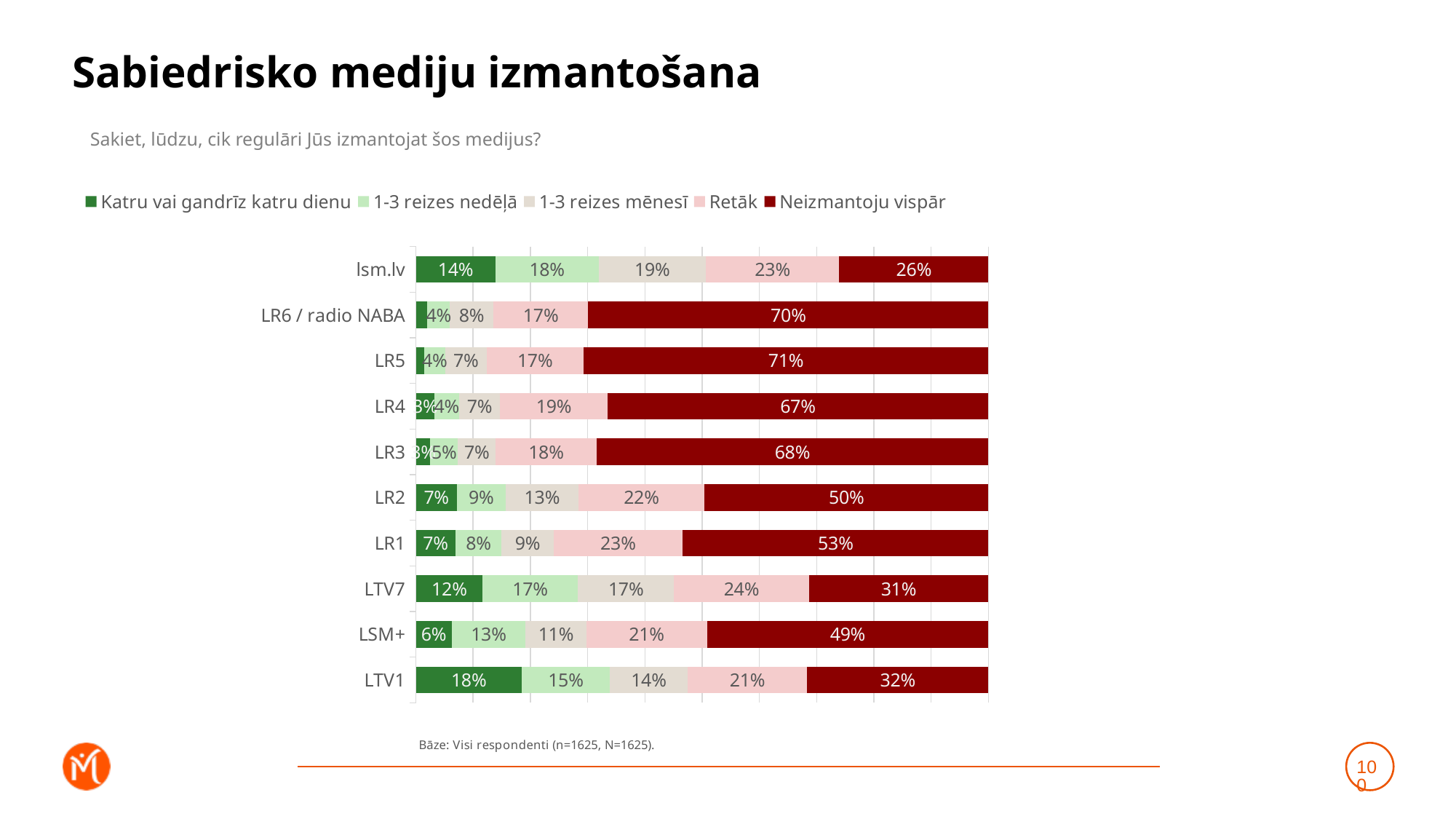
Which category has the highest 'Neizmantoju vispār' value? LR5 What kind of chart is shown on the slide? stacked bar chart What is the difference between the 'Neizmantoju vispār' values for LR1 and LR2? 3% How many series does the legend list? 5 Which category has the lowest 'Neizmantoju vispār' value? lsm.lv Which series is shown in dark red in the legend? Neizmantoju vispār How many media categories are listed on the chart? 10 What is the 'Katru vai gandrīz katru dienu' value for LTV1? 18% Which category has the highest 'Katru vai gandrīz katru dienu' value? LTV1 Which is larger: the '1-3 reizes nedēļā' value for lsm.lv or for LSM+? lsm.lv What is the 'Retāk' value for LTV7? 24% What is the 'Neizmantoju vispār' value for LR5? 71%